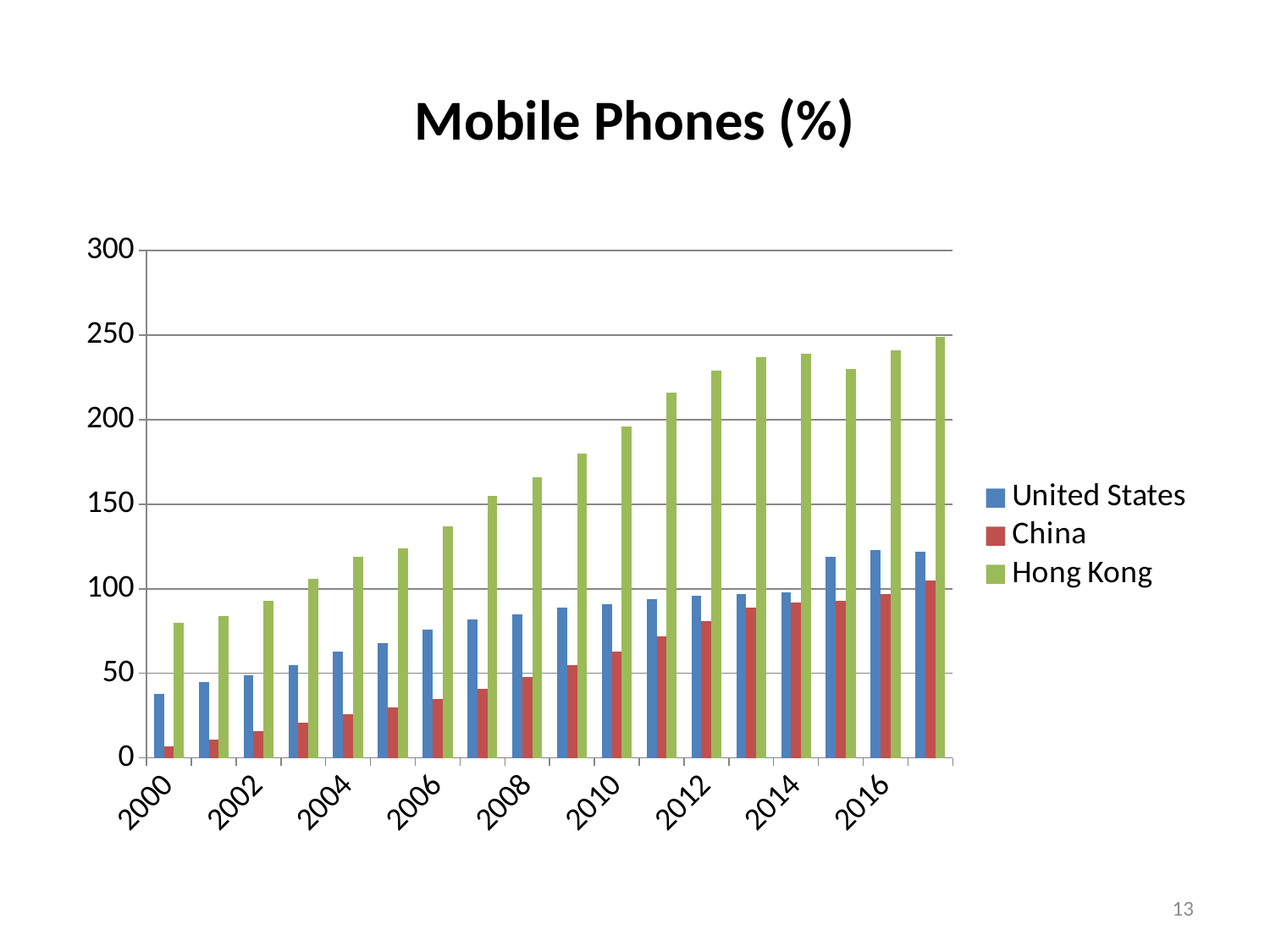
What kind of chart is shown on the slide? bar chart In 2010, which is larger: the value for United States or the value for China? United States Which series has the lowest value in 2000? China Do the values for China rise or fall from 2000 to 2016? rise Is the value for Hong Kong in 2016 greater or less than 200? greater What is the title of the chart? Mobile Phones (%) Which series has the highest value in 2016? Hong Kong Is the value for Hong Kong in 2000 greater or less than 100? less How many series does the legend list? 3 Which series is shown in green in the legend? Hong Kong Is the value for China in 2010 greater or less than 100? less